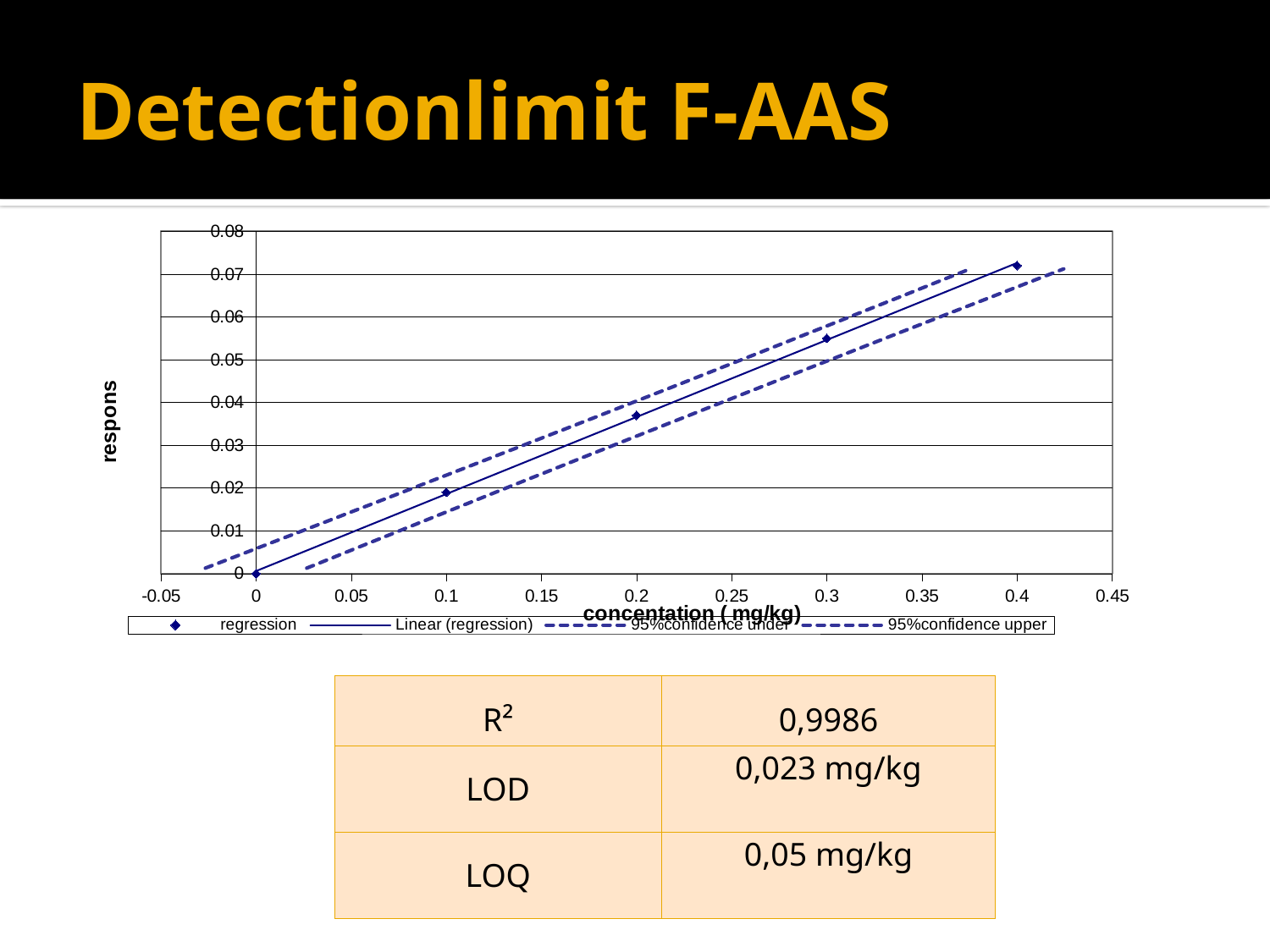
How many series does the chart legend list? 4 What is the label of the x axis of the chart? concentation ( mg/kg) How many regression data points are plotted on the chart? 5 What is the label of the y axis of the chart? respons Which has the larger regression response: concentration 0.2 or concentration 0.3? 0.3 Is the regression response at concentration 0.2 greater or less than 0.04? less At which concentration is the regression response lowest? 0 What kind of chart is shown on the slide? scatter chart with a regression line Is the regression response at concentration 0.3 greater or less than 0.05? greater Do the regression values rise or fall as concentration increases along the x axis? rise Is the regression response at concentration 0.1 greater or less than 0.01? greater At which concentration is the regression response highest? 0.4